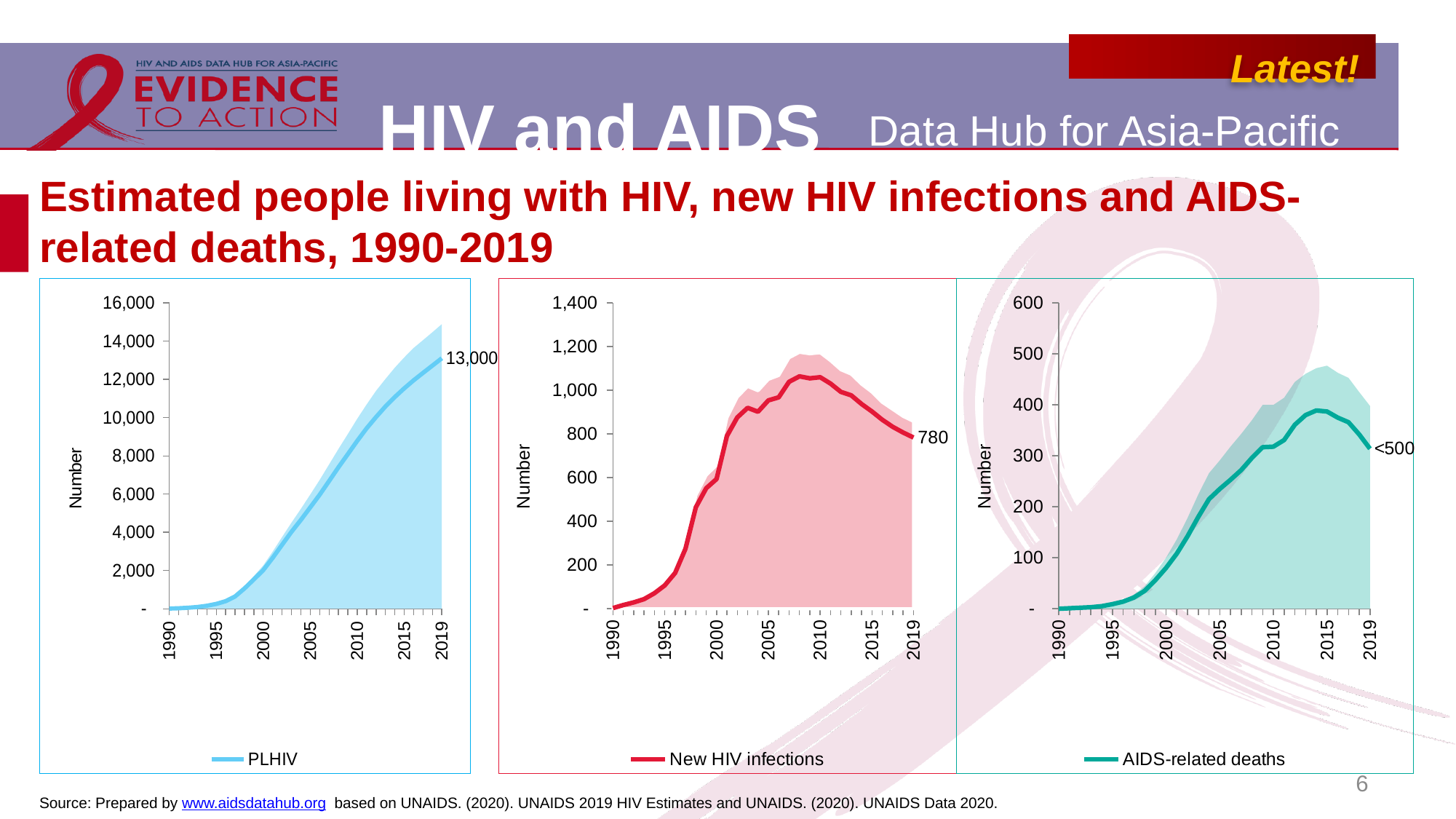
In the middle chart (New HIV infections), do the values rise or fall between 2010 and 2019? fall In the left chart (PLHIV), what is the labelled value for 2019? 13,000 In the middle chart (New HIV infections), which year has the larger value, 2000 or 2010? 2010 How many series does the legend of the right chart list? 1 In the middle chart (New HIV infections), what is the labelled value for 2019? 780 In the right chart (AIDS-related deaths), what is the labelled value for 2019? <500 In the left chart (PLHIV), is the value for 2005 greater or less than 8,000? less In the right chart (AIDS-related deaths), do the values rise or fall between 2015 and 2019? fall In the right chart (AIDS-related deaths), is the value for 2005 greater or less than 300? less In the left chart (PLHIV), what kind of chart is used to show the data? line chart In the middle chart (New HIV infections), is the value for 2010 greater or less than 1,000? greater In the left chart (PLHIV), do the values rise or fall from 1990 to 2019? rise